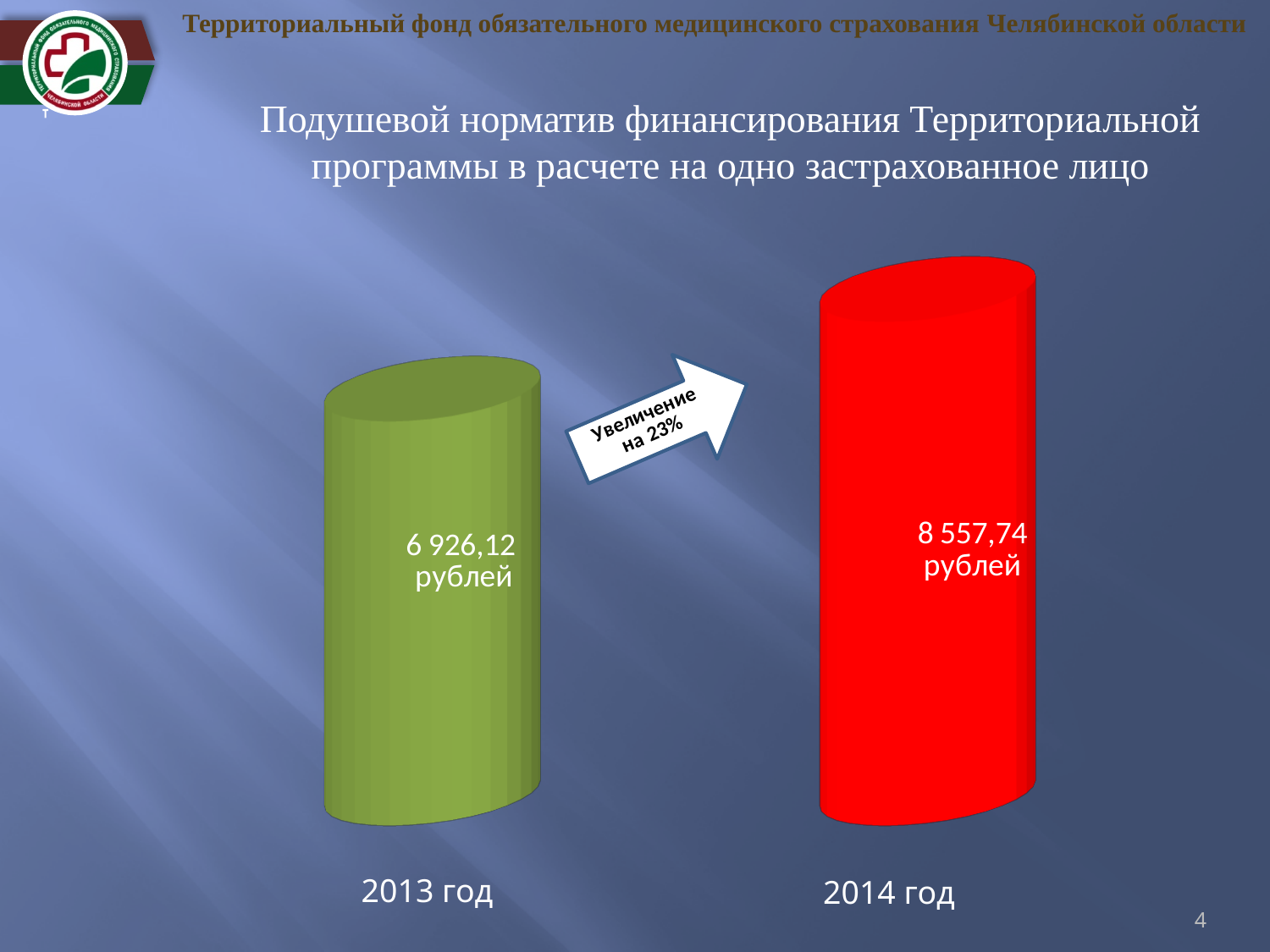
Which year has the lower per-capita funding standard? 2013 год Do the values rise or fall from 2013 год to 2014 год? rise Is the value for 2014 год larger or smaller than the value for 2013 год? larger Which year has the higher per-capita funding standard? 2014 год How many categories (years) are plotted on the chart? 2 What percentage increase does the arrow between the bars indicate? Увеличение на 23% What is the value shown for 2013 год? 6 926,12 рублей What kind of chart is shown on the slide? bar chart What is the value shown for 2014 год? 8 557,74 рублей By how much does the value for 2014 год exceed the value for 2013 год? 1 631,62 рублей What colour is the bar for 2014 год? red